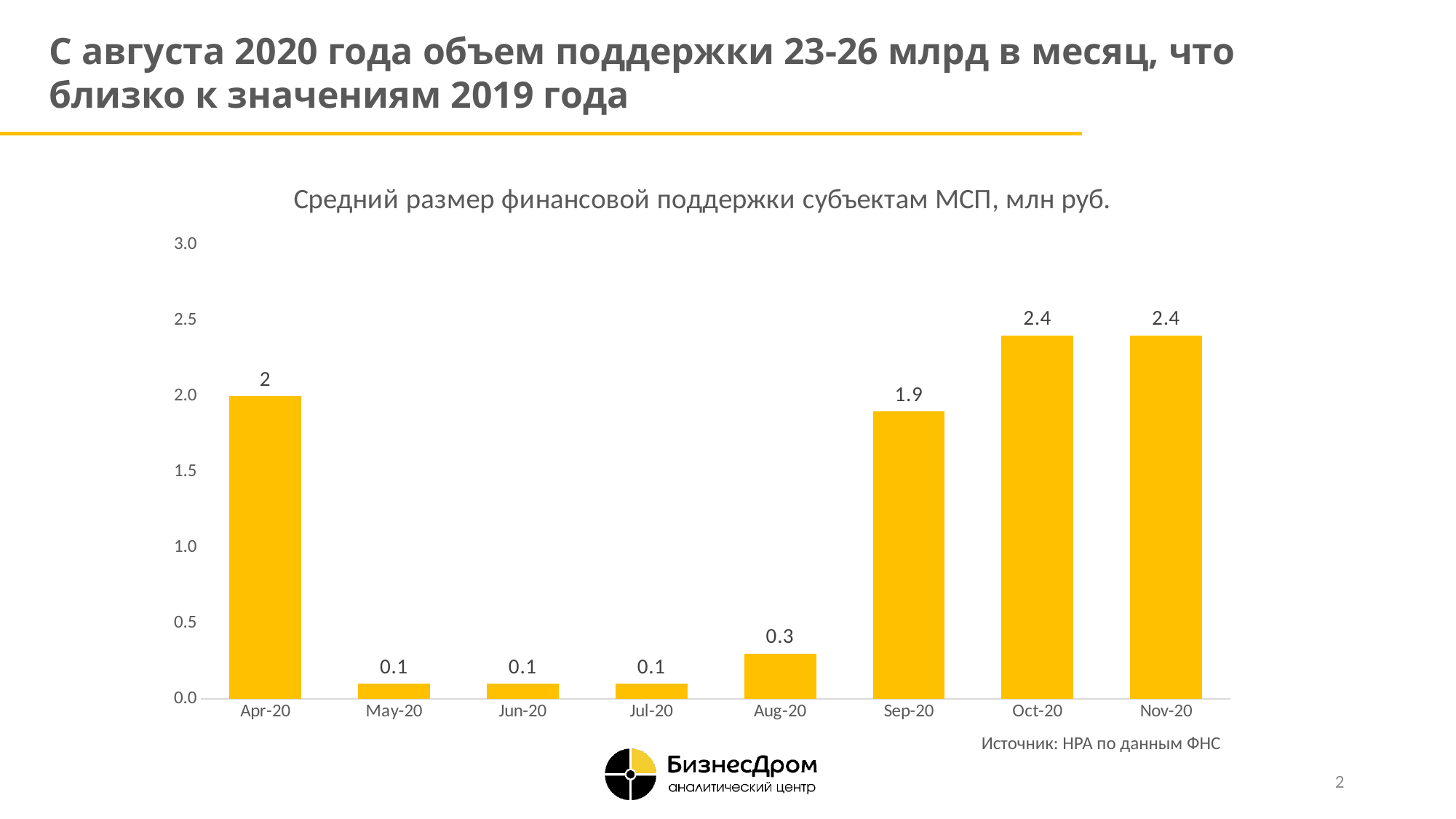
What is the value for Aug-20? 0.3 What is the difference between the values for Apr-20 and Aug-20? 1.7 What kind of chart is shown on the slide? bar chart Which month has the lowest value among Apr-20, Aug-20 and Sep-20? Aug-20 Which is larger, the value for Apr-20 or the value for Nov-20? Nov-20 What is the value for Sep-20? 1.9 What is the value for Apr-20? 2 Is the value for Sep-20 greater or less than 1.5? greater How many months are shown on the x axis? 8 What is the value for Oct-20? 2.4 What is the title of the chart? Средний размер финансовой поддержки субъектам МСП, млн руб. What is the difference between the values for Oct-20 and Sep-20? 0.5